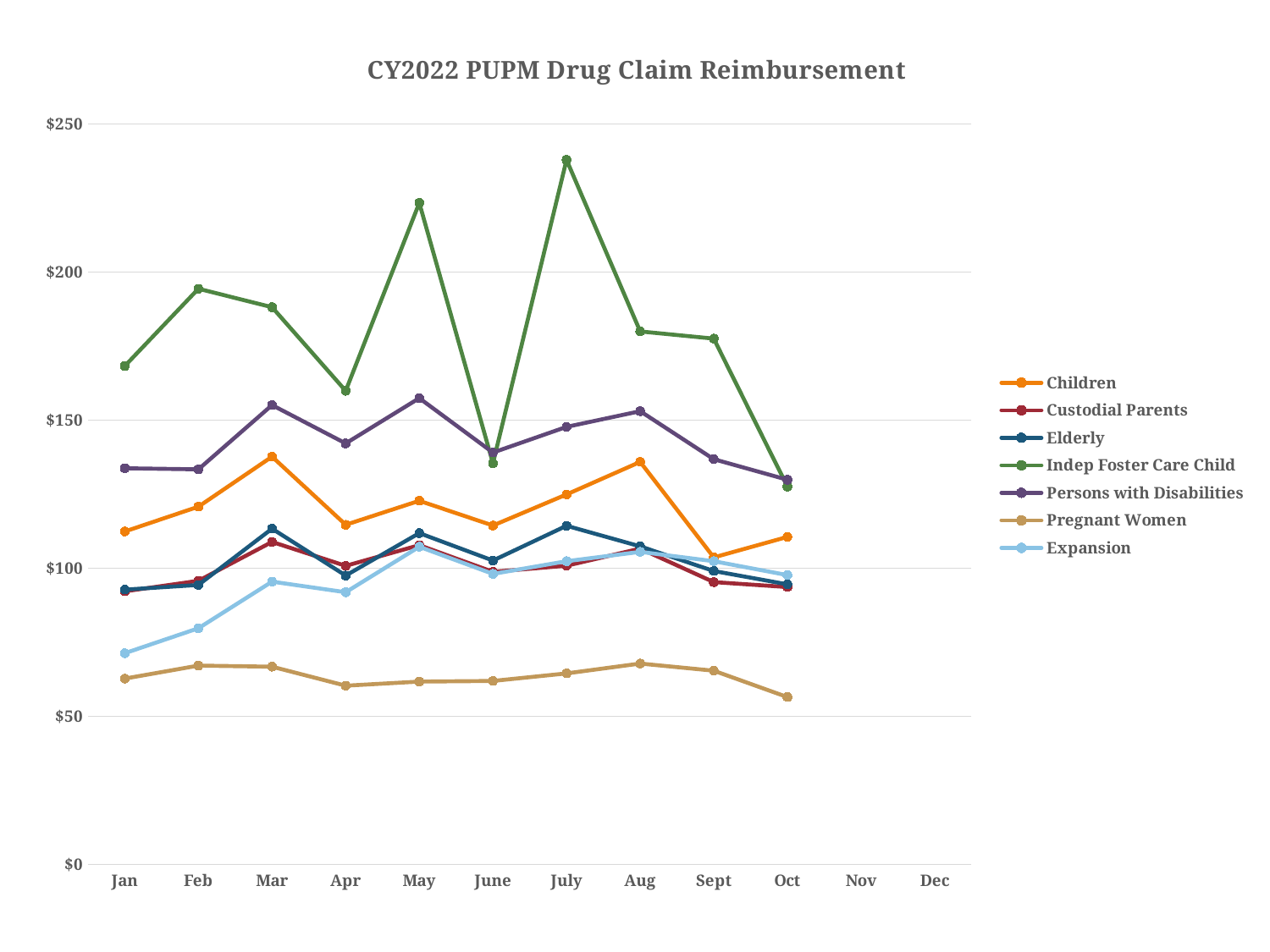
In which month does the Indep Foster Care Child series reach its highest value? July For the Children series, which is larger: the value in Aug or the value in Sept? Aug Which series has the lowest value in every month plotted? Pregnant Women What kind of chart is shown on the slide? line chart Which series has the highest value in July? Indep Foster Care Child Does the Expansion series rise or fall from Jan to Mar? rise Is the value for Expansion in Jan greater or less than $100? less How many months have plotted data points on the chart? 10 Is the value for Persons with Disabilities in Apr greater or less than $150? less How many series does the legend list? 7 Is the value for Indep Foster Care Child in July greater or less than $200? greater What is the title of the chart? CY2022 PUPM Drug Claim Reimbursement